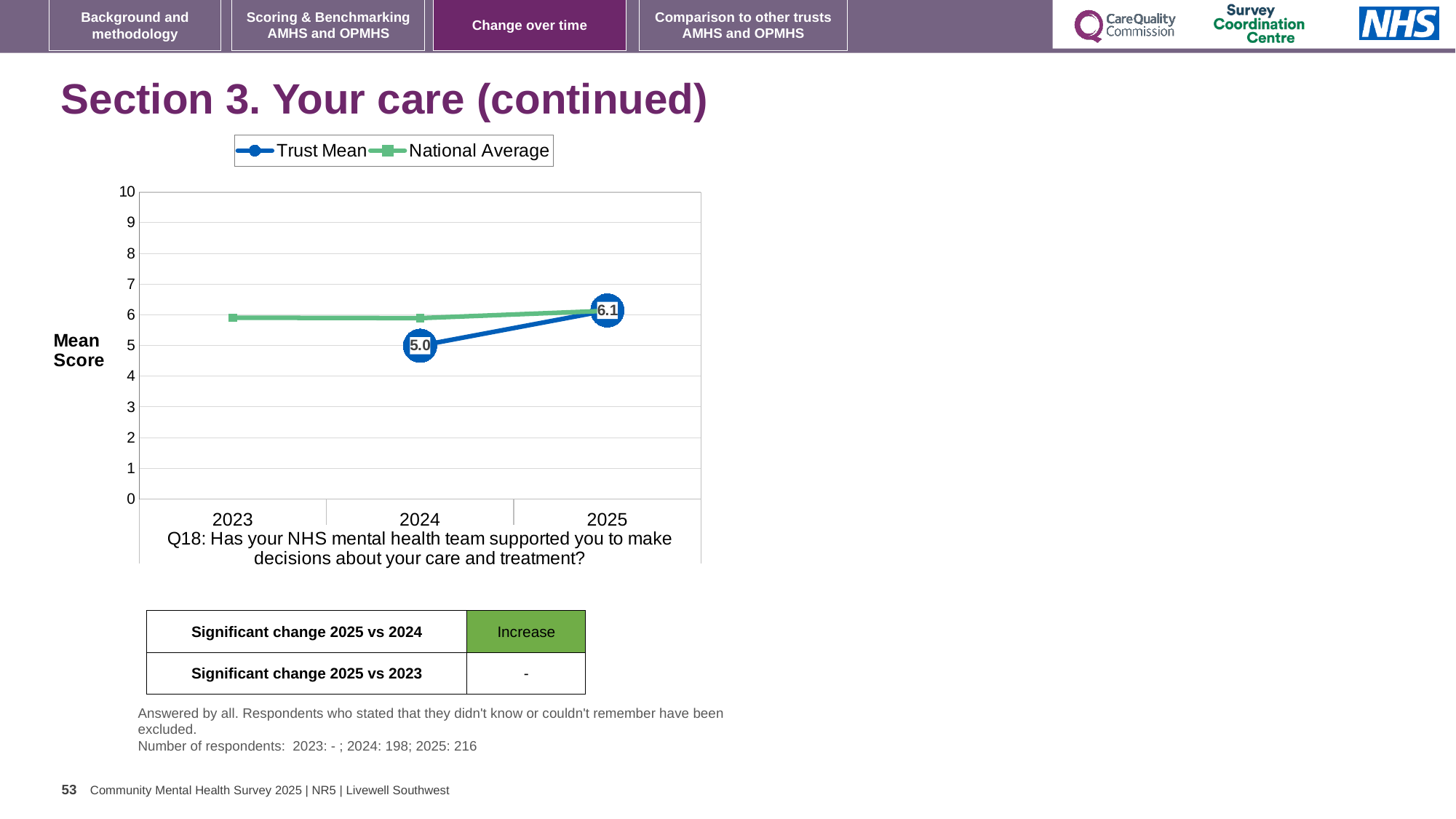
In which year is the Trust Mean highest? 2025 What is the Trust Mean value for 2025? 6.1 What is the label on the y axis of the chart? Mean Score What is the Trust Mean value for 2024? 5.0 By how much did the Trust Mean change from 2024 to 2025? 1.1 How many years are shown on the x axis? 3 What kind of chart is shown on the slide? line chart What are the two series named in the legend? Trust Mean and National Average Is the National Average value for 2023 greater or less than 5? greater How many series does the legend list? 2 Does the Trust Mean rise or fall from 2024 to 2025? rise In 2024, which is larger: the Trust Mean or the National Average? National Average